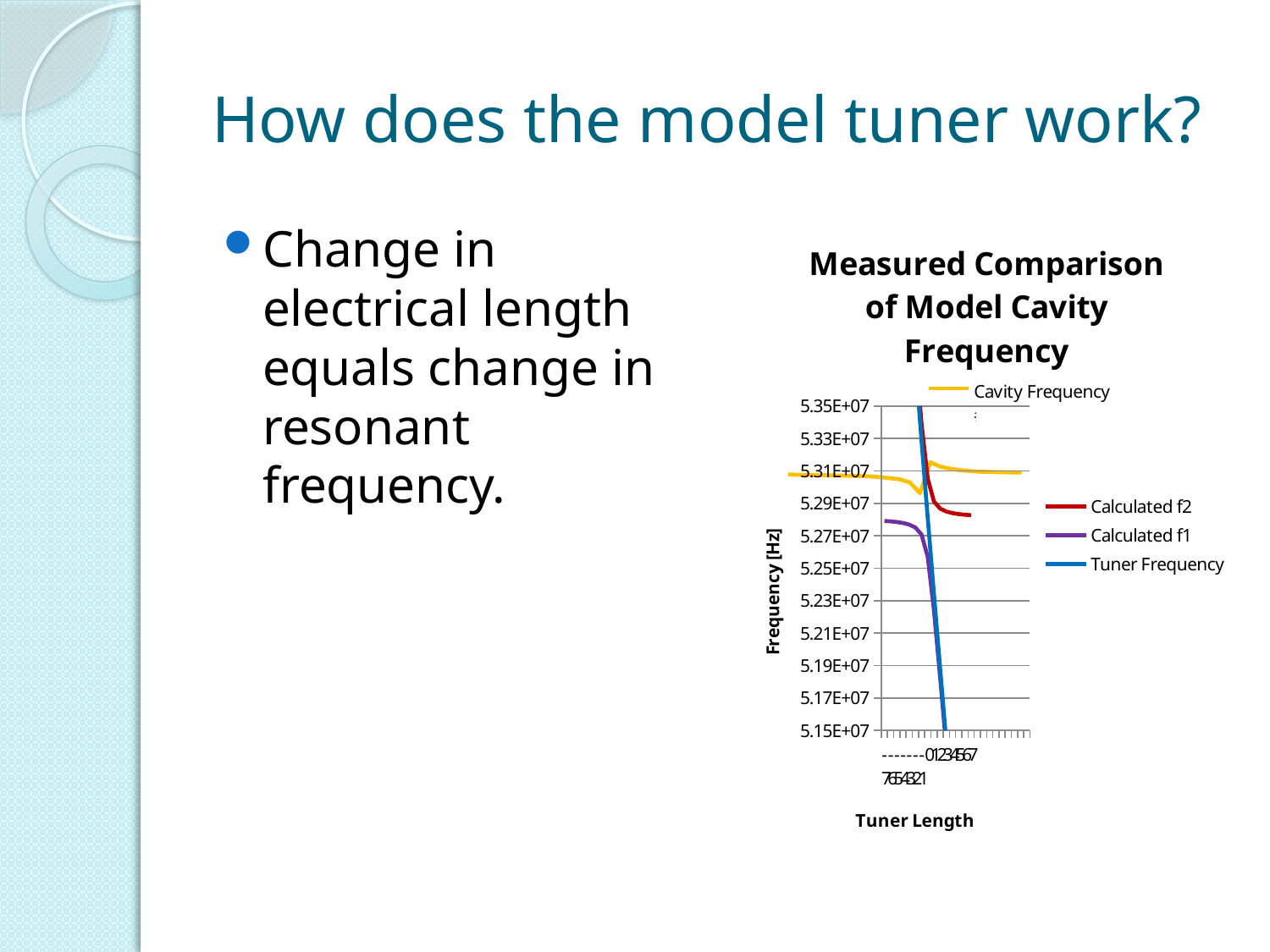
What is the title of the chart? Measured Comparison of Model Cavity Frequency Is the value of Calculated f2 at the right end of the chart greater or less than 5.29E+07? less Is the value of Calculated f1 at the left end of the chart greater or less than 5.29E+07? less Is the lowest value reached by the Tuner Frequency line greater or less than 5.17E+07? less At the right end of the chart, which is higher: Cavity Frequency or Calculated f2? Cavity Frequency At the left end of the chart, which is higher: Cavity Frequency or Calculated f1? Cavity Frequency Does the Tuner Frequency line rise or fall as Tuner Length increases along the x axis? fall How many series does the chart legend list? 4 What kind of chart is shown on the slide? line chart What colour is the Calculated f1 line in the chart? purple